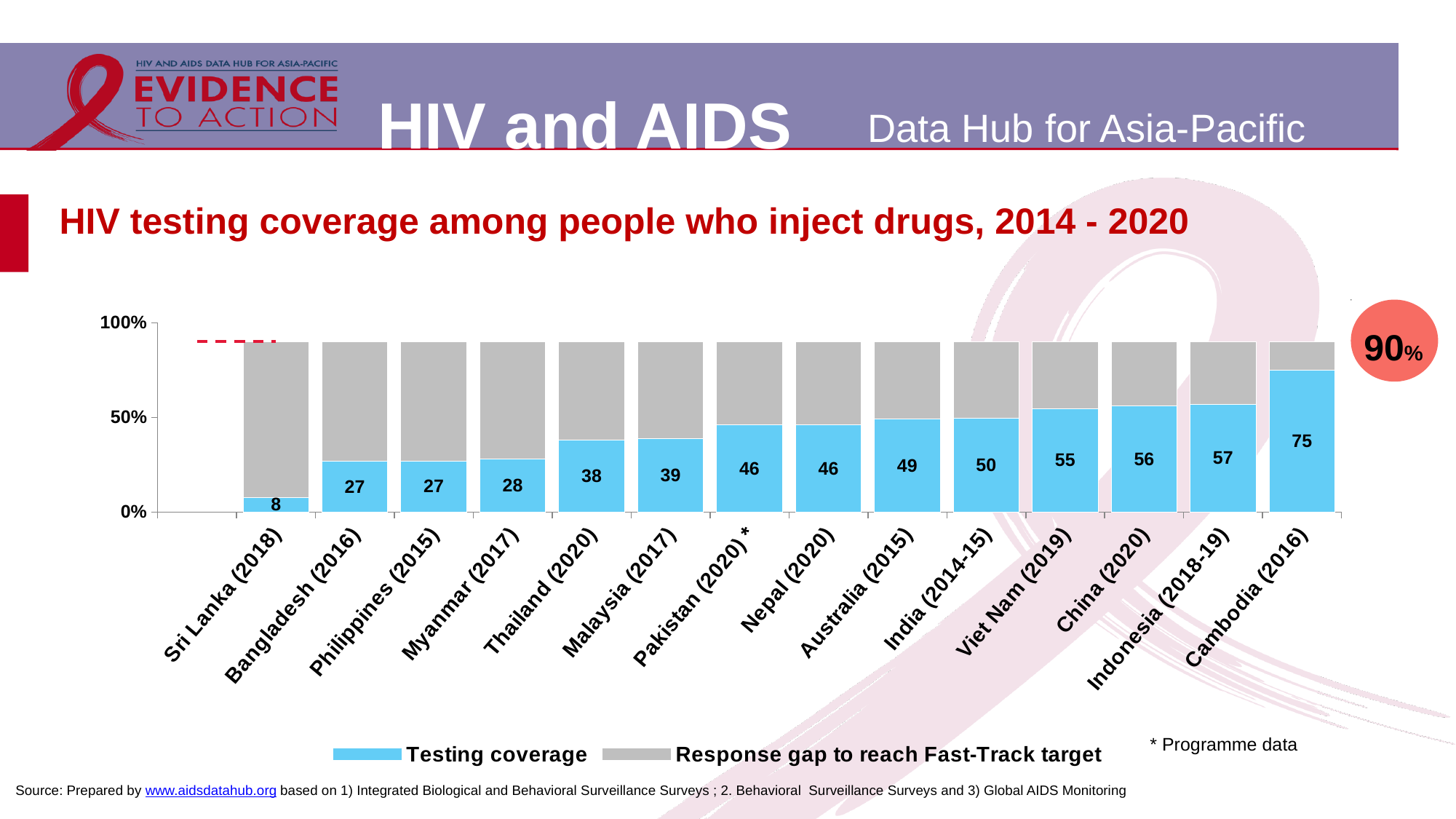
How many countries are shown on the x axis of the chart? 14 How many series does the legend list? 2 Which country has the highest testing coverage in the chart? Cambodia (2016) What is the testing coverage value shown for Cambodia (2016)? 75 Is the testing coverage value for Indonesia (2018-19) greater or less than 50%? greater Which country has the lowest testing coverage in the chart? Sri Lanka (2018) What kind of chart is shown on the slide? Stacked bar chart Which has a higher testing coverage value, Viet Nam (2019) or Malaysia (2017)? Viet Nam (2019) What is the testing coverage value shown for Thailand (2020)? 38 What is the testing coverage value shown for Sri Lanka (2018)? 8 Which legend entry is shown in grey? Response gap to reach Fast-Track target What is the difference between the testing coverage values for Cambodia (2016) and Sri Lanka (2018)? 67